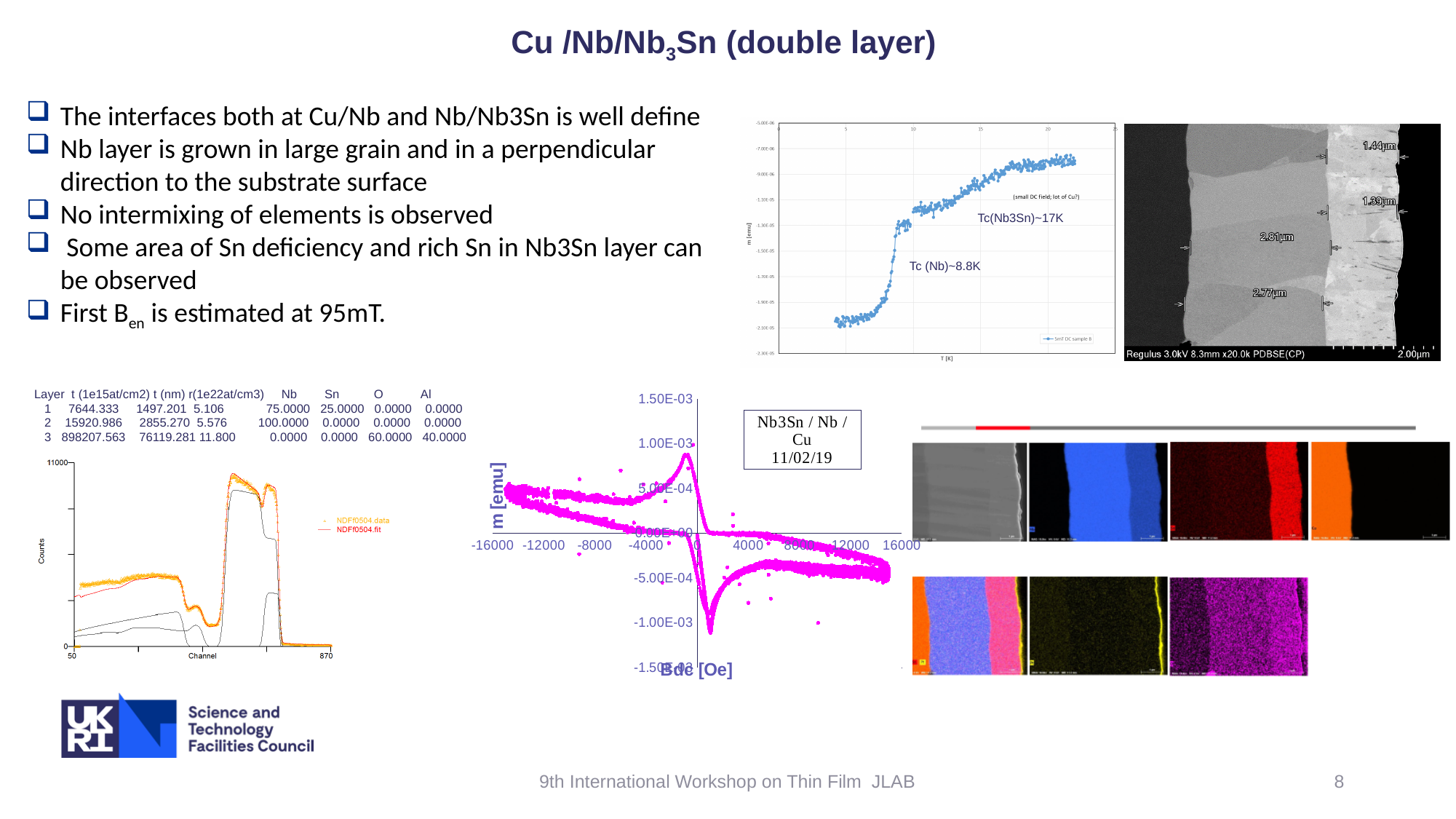
In the middle hysteresis chart, is the highest value of m [emu] greater or less than 5.00E-04? greater How many series does the legend of the bottom-left Counts versus Channel chart list? 2 What is the x-axis label of the middle hysteresis chart? Bdc [Oe] What kind of chart is the m [emu] versus Bdc [Oe] chart in the middle of the slide? scatter chart In the bottom-left Counts versus Channel chart, is the peak count greater or less than 11000? less What kind of chart is the top-right chart plotting m [emu] against T [K]? scatter chart What are the two legend entries of the bottom-left Counts versus Channel chart? NDFf0504.data and NDFf0504.fit In the top-right chart, does m [emu] rise or fall as T [K] increases? rise What is the x-axis label of the top-right chart? T [K]